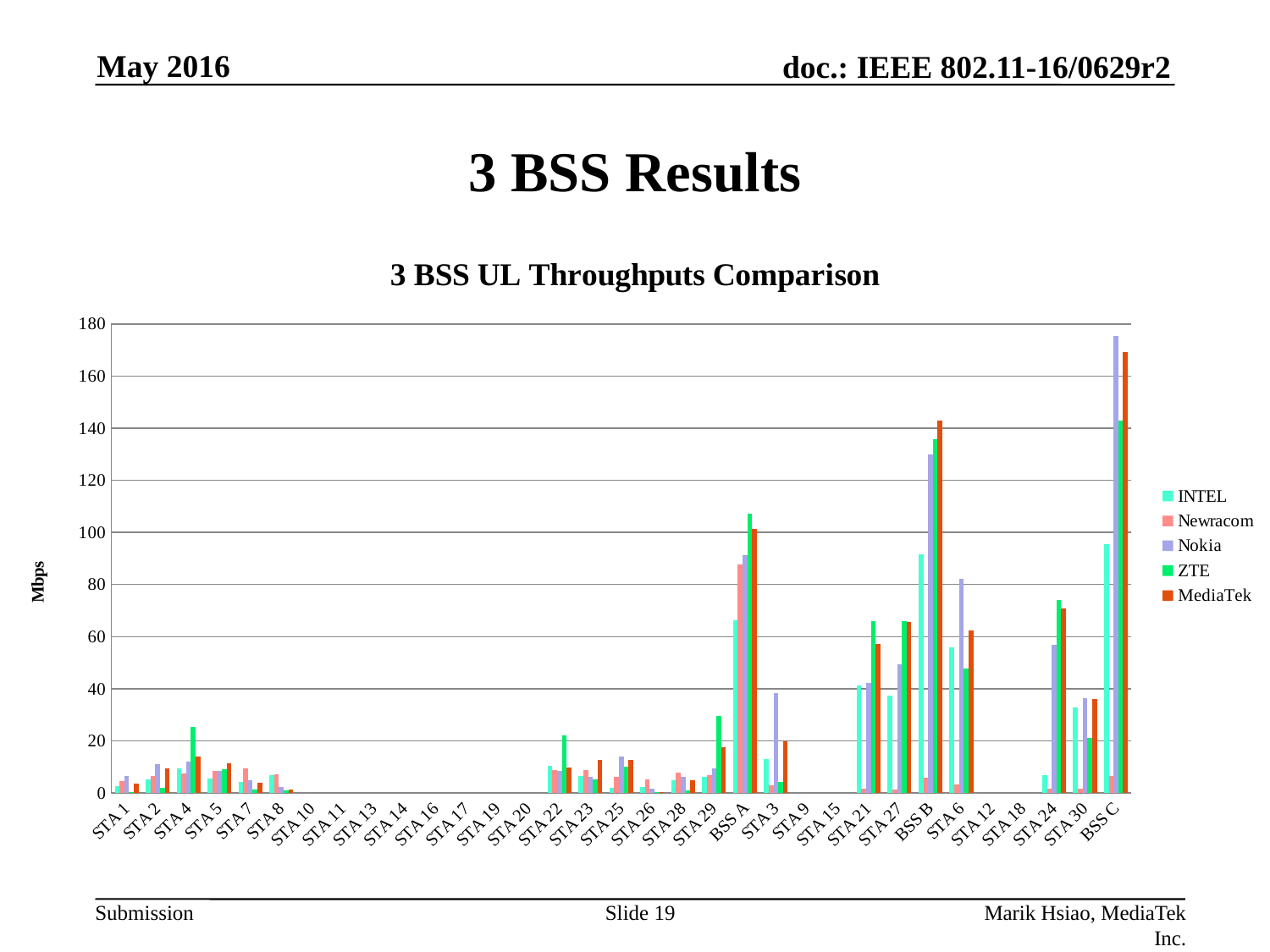
How many series does the legend list? 5 Is the Nokia value for BSS C greater or less than 160? greater What kind of chart is shown on the slide? bar chart Is the INTEL value for BSS B greater or less than 100? less What is the label on the vertical axis? Mbps Is the ZTE value for BSS A greater or less than 100? greater How many categories are shown along the x axis? 33 For BSS B, which is larger: the ZTE value or the INTEL value? ZTE For STA 6, which is larger: the Nokia value or the INTEL value? Nokia Which category has the highest Nokia value? BSS C What is the title of the chart? 3 BSS UL Throughputs Comparison